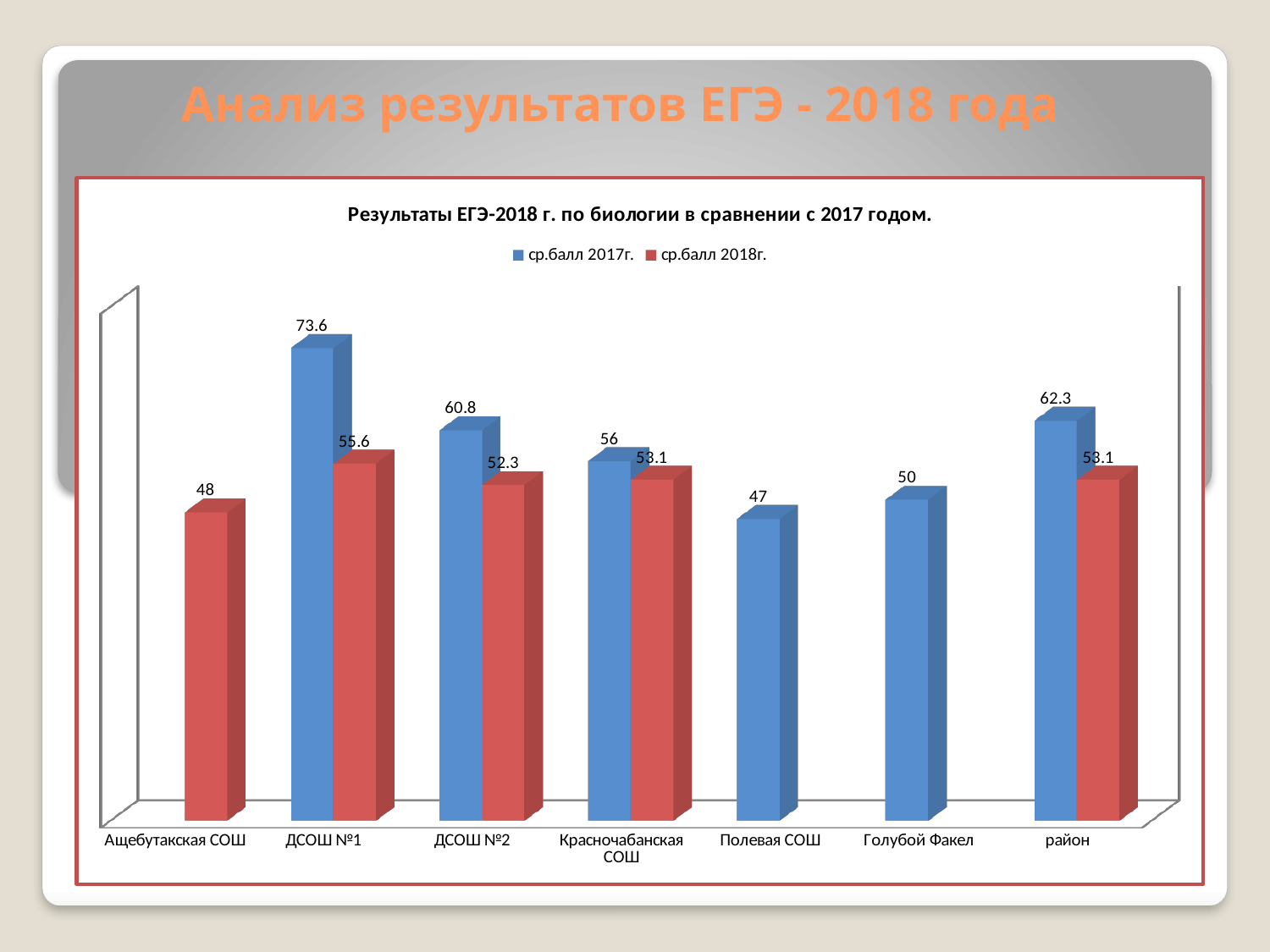
How many series does the legend list? 2 What is the 2018 average score (ср.балл 2018г.) for ДСОШ №2? 52.3 Which category has the highest value for ср.балл 2017г.? ДСОШ №1 Which is larger for Красночабанская СОШ: ср.балл 2017г. or ср.балл 2018г.? ср.балл 2017г. What is the average score for 2018 (ср.балл 2018г.) for Ащебутакская СОШ? 48 What is the 2017 average score (ср.балл 2017г.) for Полевая СОШ? 47 What is the difference between the 2017 and 2018 average scores for район? 9.2 What is the average score for 2017 (ср.балл 2017г.) for ДСОШ №1? 73.6 Which category has the lowest value for ср.балл 2017г.? Полевая СОШ Which category has the highest value for ср.балл 2018г.? ДСОШ №1 What is the difference between the 2017 and 2018 average scores for ДСОШ №1? 18 How many categories are shown on the x axis of the chart? 7